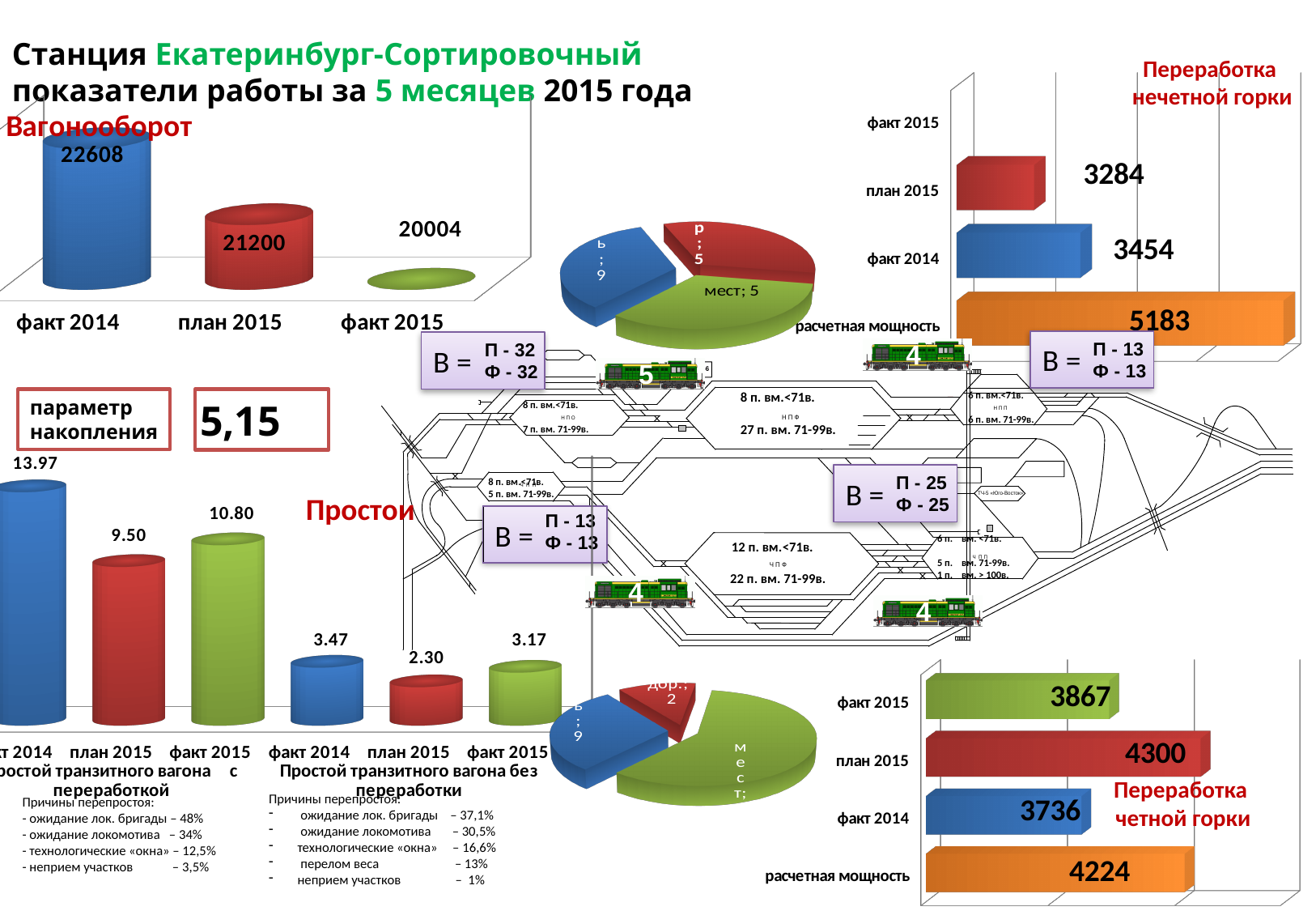
On the Простои chart, what is the value for факт 2014 for Простой транзитного вагона с переработкой? 13.97 On the Переработка четной горки chart, what is the difference between факт 2015 and факт 2014? 131 On the Переработка нечетной горки chart, what is the value for расчетная мощность? 5183 On the Вагонооборот chart, what is the value for план 2015? 21200 On the Переработка четной горки chart, which category has the highest value? план 2015 On the Переработка четной горки chart, what is the value for план 2015? 4300 On the Вагонооборот chart, which category has the lowest value? факт 2015 What kind of chart is the Вагонооборот chart? bar chart On the Простои chart, what is the value for план 2015 for Простой транзитного вагона без переработки? 2.30 On the Вагонооборот chart, what is the difference between факт 2014 and факт 2015? 2604 On the Вагонооборот chart, what is the value for факт 2014? 22608 On the Переработка нечетной горки chart, which is larger, план 2015 or факт 2014? факт 2014